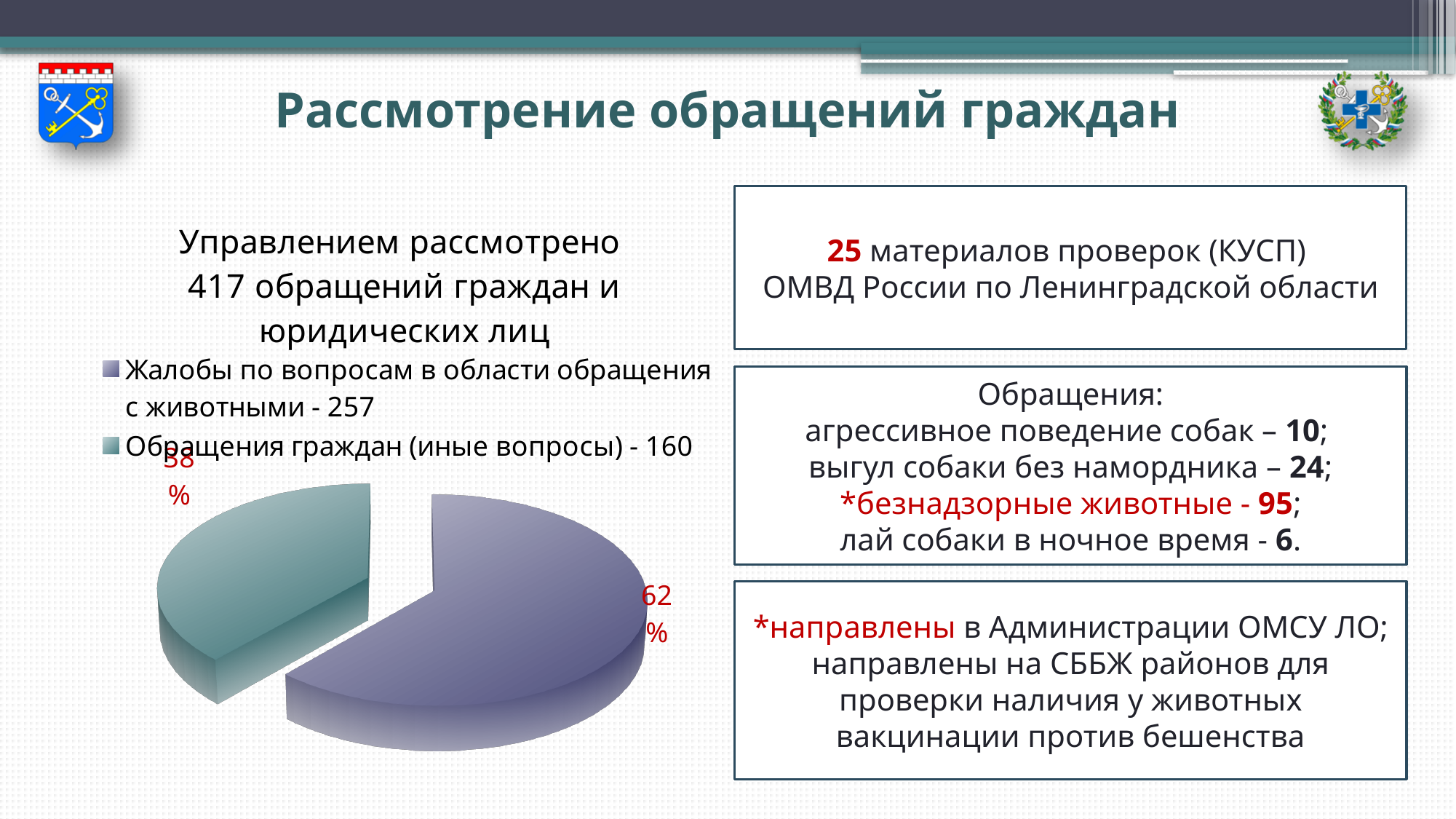
What is the total number of appeals stated in the chart title? 417 Which category has the smallest slice of the pie? Обращения граждан (иные вопросы) According to the legend, how many 'Обращения граждан (иные вопросы)' were there? 160 According to the legend, how many 'Жалобы по вопросам в области обращения с животными' were there? 257 By how many percentage points does the share of 'Жалобы по вопросам в области обращения с животными' exceed the share of 'Обращения граждан (иные вопросы)'? 24 percentage points Which category has the largest slice of the pie? Жалобы по вопросам в области обращения с животными What is the difference between the number of 'Жалобы по вопросам в области обращения с животными' (257) and 'Обращения граждан (иные вопросы)' (160)? 97 How many entries does the legend of the pie chart list? 2 What kind of chart is shown on the slide? Pie chart What percentage of the pie is labelled for 'Жалобы по вопросам в области обращения с животными'? 62% What percentage of the pie is labelled for 'Обращения граждан (иные вопросы)'? 38% How many slices does the pie chart have? 2